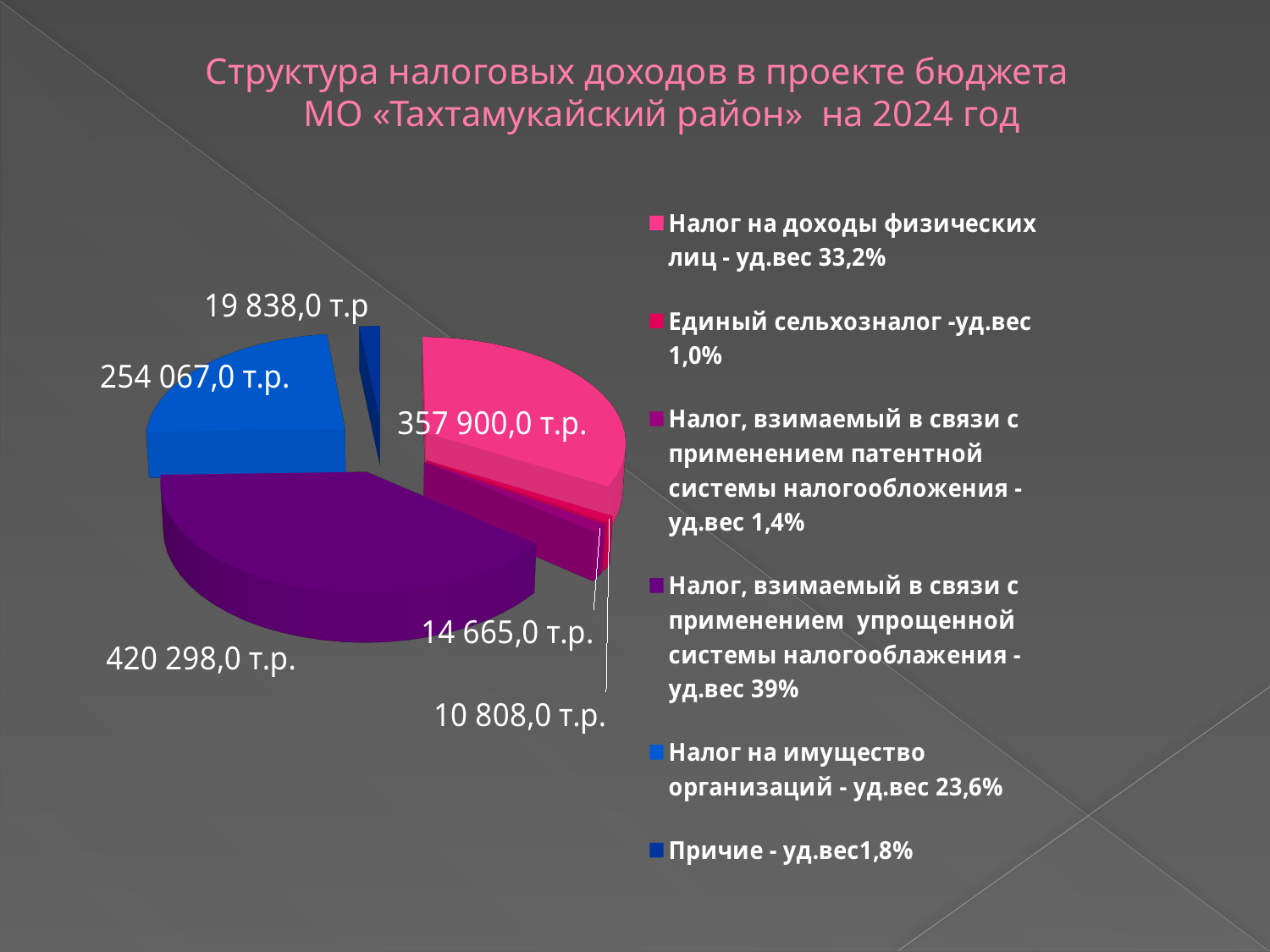
How many slices does the pie chart have? 6 What kind of chart is shown on the slide? Pie chart How many entries does the legend list? 6 What is the smallest value printed on the pie chart? 10 808,0 т.р. What share of the pie does Налог на доходы физических лиц have according to the legend? 33,2% What is the difference between the largest value (420 298,0 т.р.) and the value for Налог на доходы физических лиц (357 900,0 т.р.)? 62 398,0 т.р. What is the value shown for Причие? 19 838,0 т.р Which category has the largest slice of the pie? Налог, взимаемый в связи с применением упрощенной системы налогооблажения What is the value shown for Налог на имущество организаций? 254 067,0 т.р. Which is larger: the value for Налог на имущество организаций or the value for Налог на доходы физических лиц? Налог на доходы физических лиц What share of the pie does the упрощенная система налогооблажения slice have according to the legend? 39% What is the value shown for Налог на доходы физических лиц? 357 900,0 т.р.